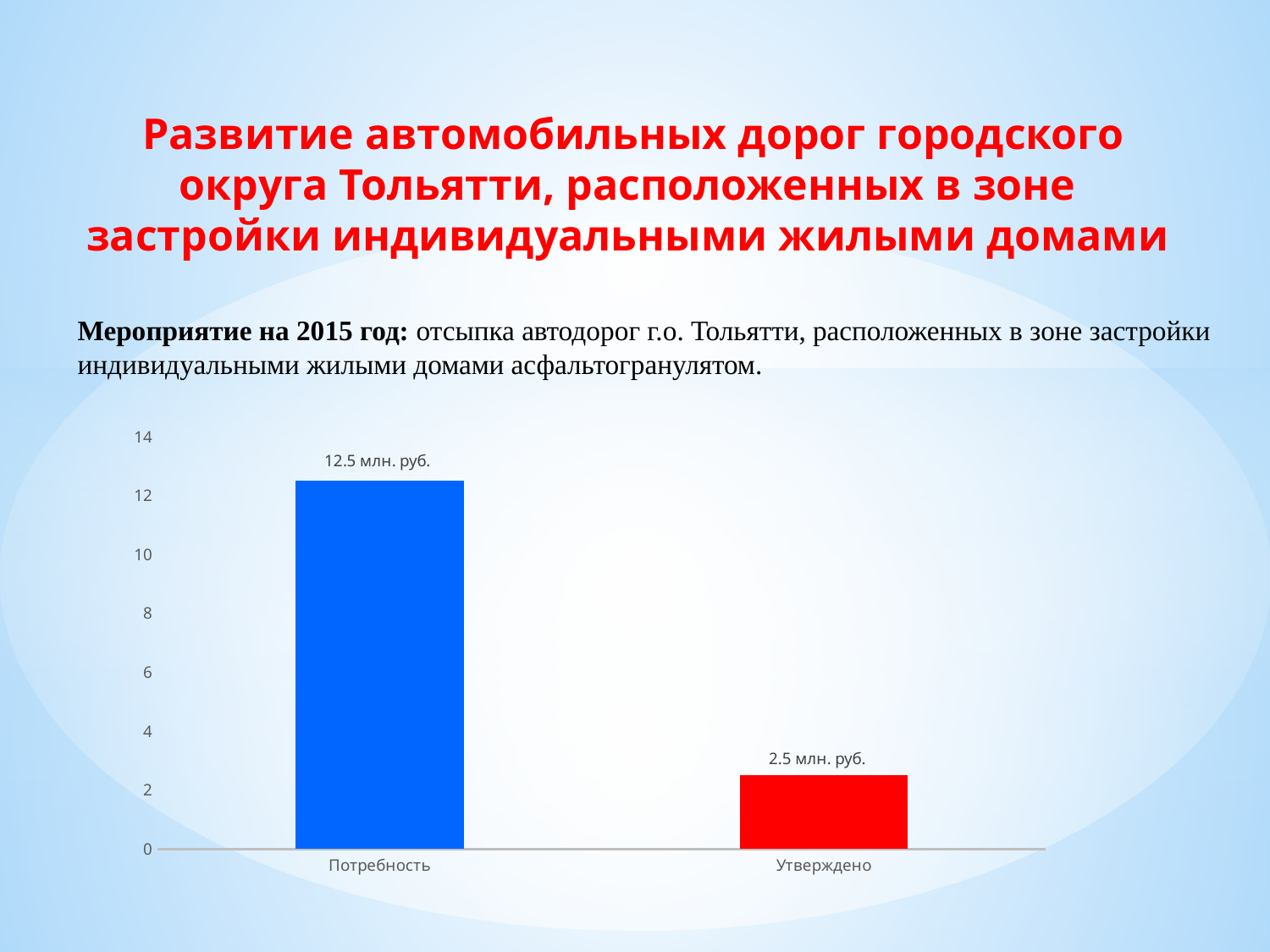
What is the value for Утверждено? 2.5 млн. руб. Which is larger, the value for Потребность or the value for Утверждено? Потребность What kind of chart is shown on the slide? bar chart What is the value for Потребность? 12.5 млн. руб. What colour is the bar for Утверждено? red What is the difference between the values for Потребность and Утверждено? 10 млн. руб. What is the highest value shown on the vertical axis? 14 Is the value for Утверждено greater or less than 4? less How many categories are shown on the chart? 2 Which category has the highest value? Потребность Is the value for Потребность greater or less than 10? greater Which category has the lowest value? Утверждено